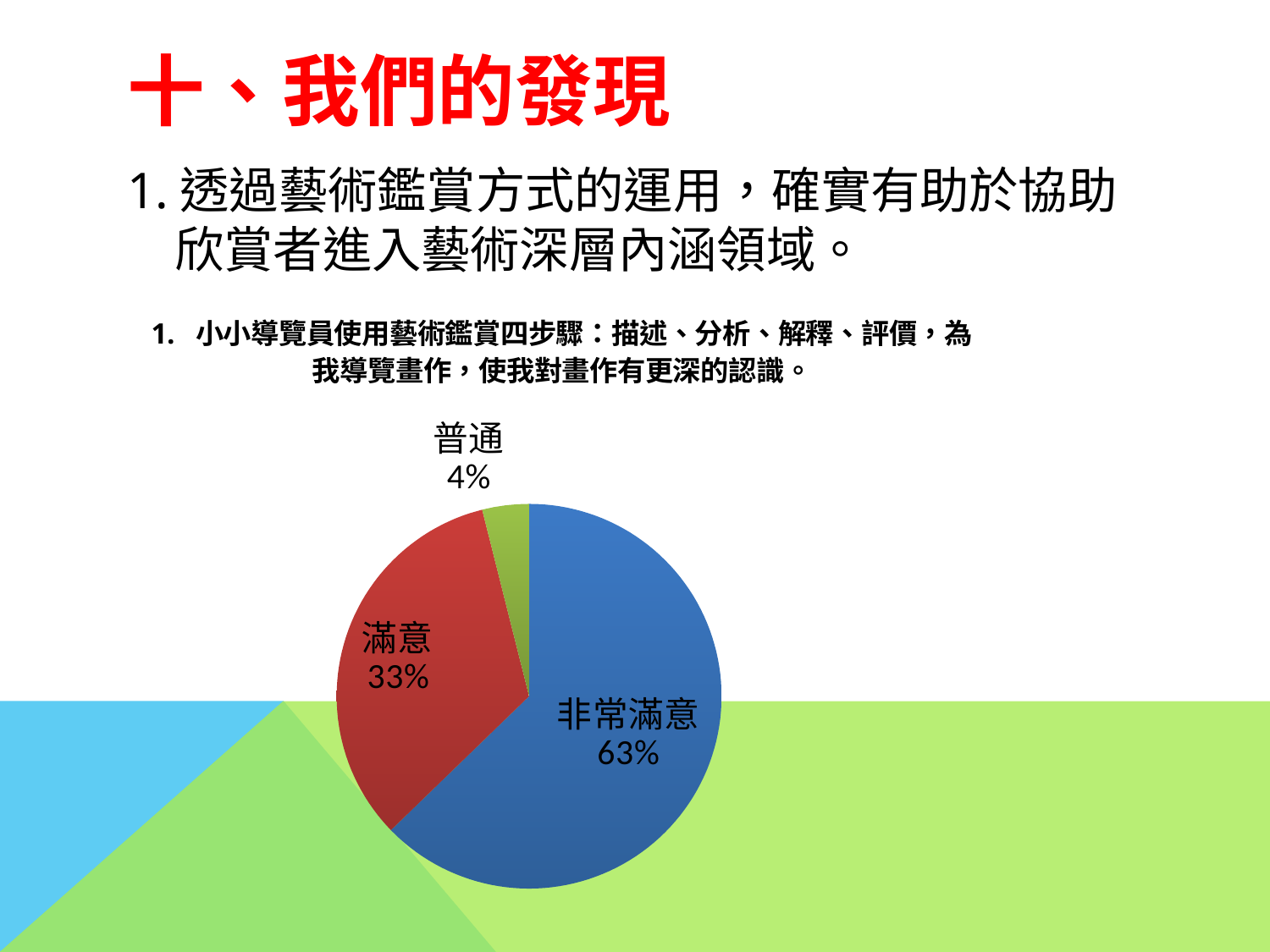
What is the difference in percentage points between the 非常滿意 slice and the 滿意 slice? 30 Which slice of the pie is the smallest? 普通 What colour is the 滿意 slice of the pie? red What is the combined share of the 非常滿意 and 滿意 slices? 96% What kind of chart is shown on the slide? pie chart What percentage of the pie is labelled 滿意? 33% What percentage of the pie is labelled 非常滿意? 63% What percentage of the pie is labelled 普通? 4% How many slices does the pie chart have? 3 Which is larger, the 滿意 slice or the 普通 slice? 滿意 Which slice of the pie is the largest? 非常滿意 What colour is the 非常滿意 slice of the pie? blue